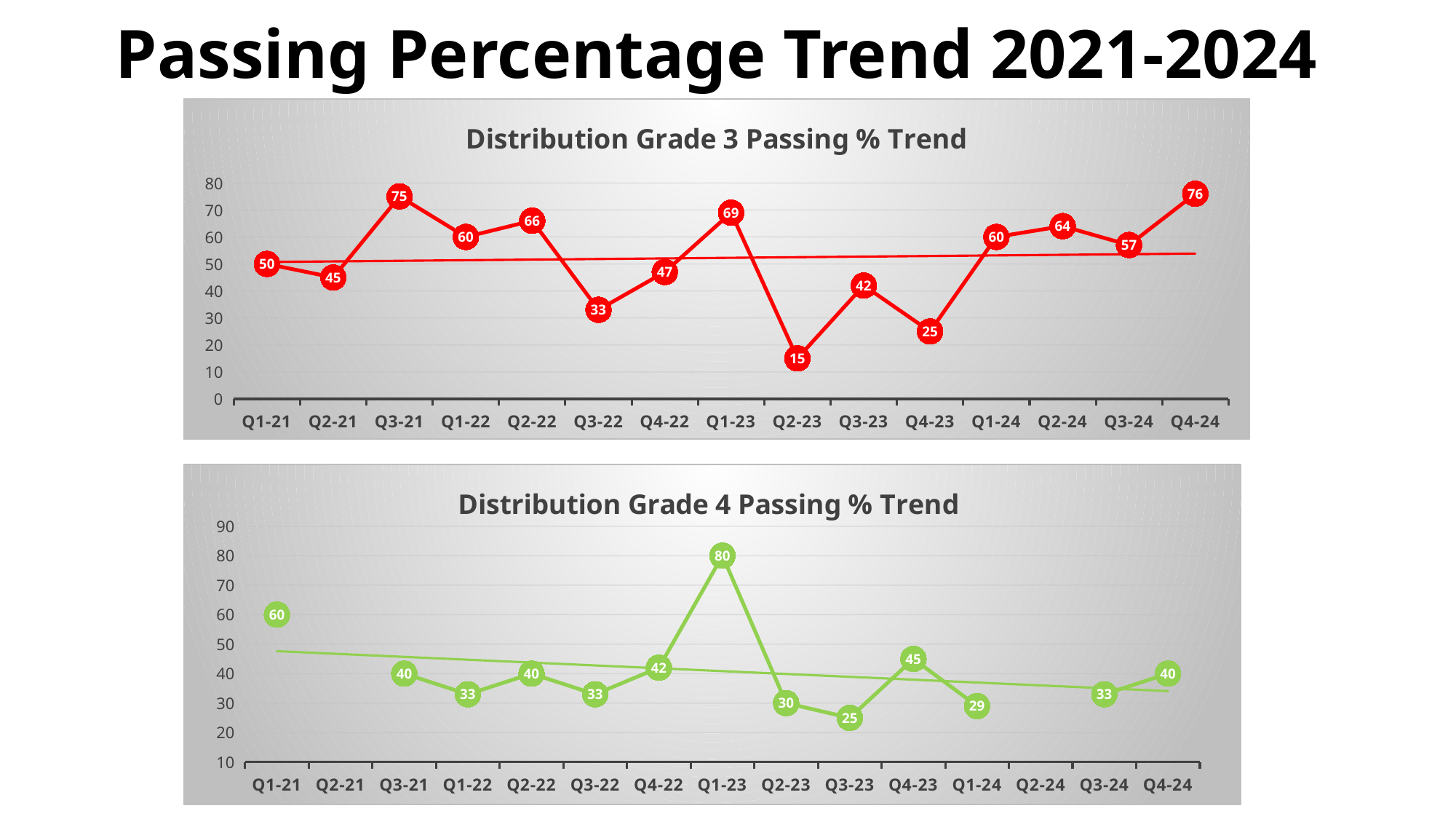
In the Distribution Grade 4 Passing % Trend chart, what is the difference between the values for Q1-21 and Q4-24? 20 In the Distribution Grade 4 Passing % Trend chart, what is the value for Q1-23? 80 In the Distribution Grade 4 Passing % Trend chart, which quarter has the lowest value? Q3-23 In the Distribution Grade 4 Passing % Trend chart, which is larger, the value for Q4-23 or the value for Q1-24? Q4-23 In the Distribution Grade 3 Passing % Trend chart, which quarter has the lowest value? Q2-23 In the Distribution Grade 3 Passing % Trend chart, how many quarters are shown on the x axis? 15 In the Distribution Grade 3 Passing % Trend chart, what is the difference between the values for Q3-21 and Q3-22? 42 In the Distribution Grade 3 Passing % Trend chart, what is the value for Q2-23? 15 In the Distribution Grade 4 Passing % Trend chart, what is the value for Q1-22? 33 What colour is the line in the Distribution Grade 4 Passing % Trend chart? Green In the Distribution Grade 3 Passing % Trend chart, which quarter has the highest value? Q4-24 What kind of chart is the Distribution Grade 3 Passing % Trend chart? Line chart